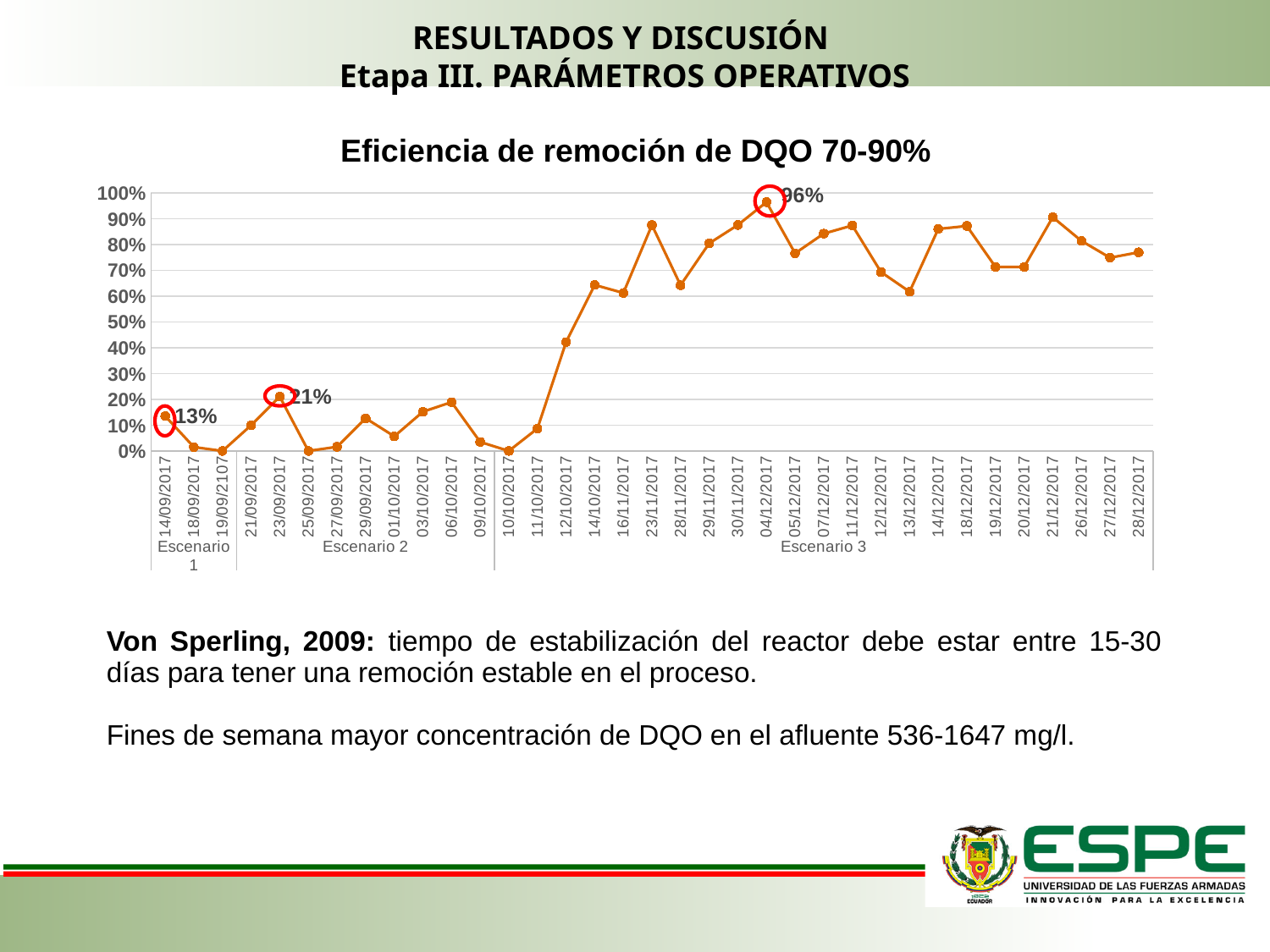
Which date has the higher efficiency, 23/09/2017 or 04/12/2017? 04/12/2017 What type of chart is shown on the slide? line chart What is the DQO removal efficiency on 14/09/2017? 13% What is the title of the chart? Eficiencia de remoción de DQO 70-90% Is the value for 13/12/2017 greater or less than 70%? less What is the DQO removal efficiency on 04/12/2017? 96% How many scenario groups (Escenarios) are labelled on the x axis? 3 Does the efficiency rise or fall between 10/10/2017 and 23/11/2017? rise On which date is the DQO removal efficiency highest? 04/12/2017 What is the difference between the efficiency on 04/12/2017 and on 14/09/2017? 83% Is the value for 23/11/2017 greater or less than 80%? greater What is the DQO removal efficiency on 23/09/2017? 21%